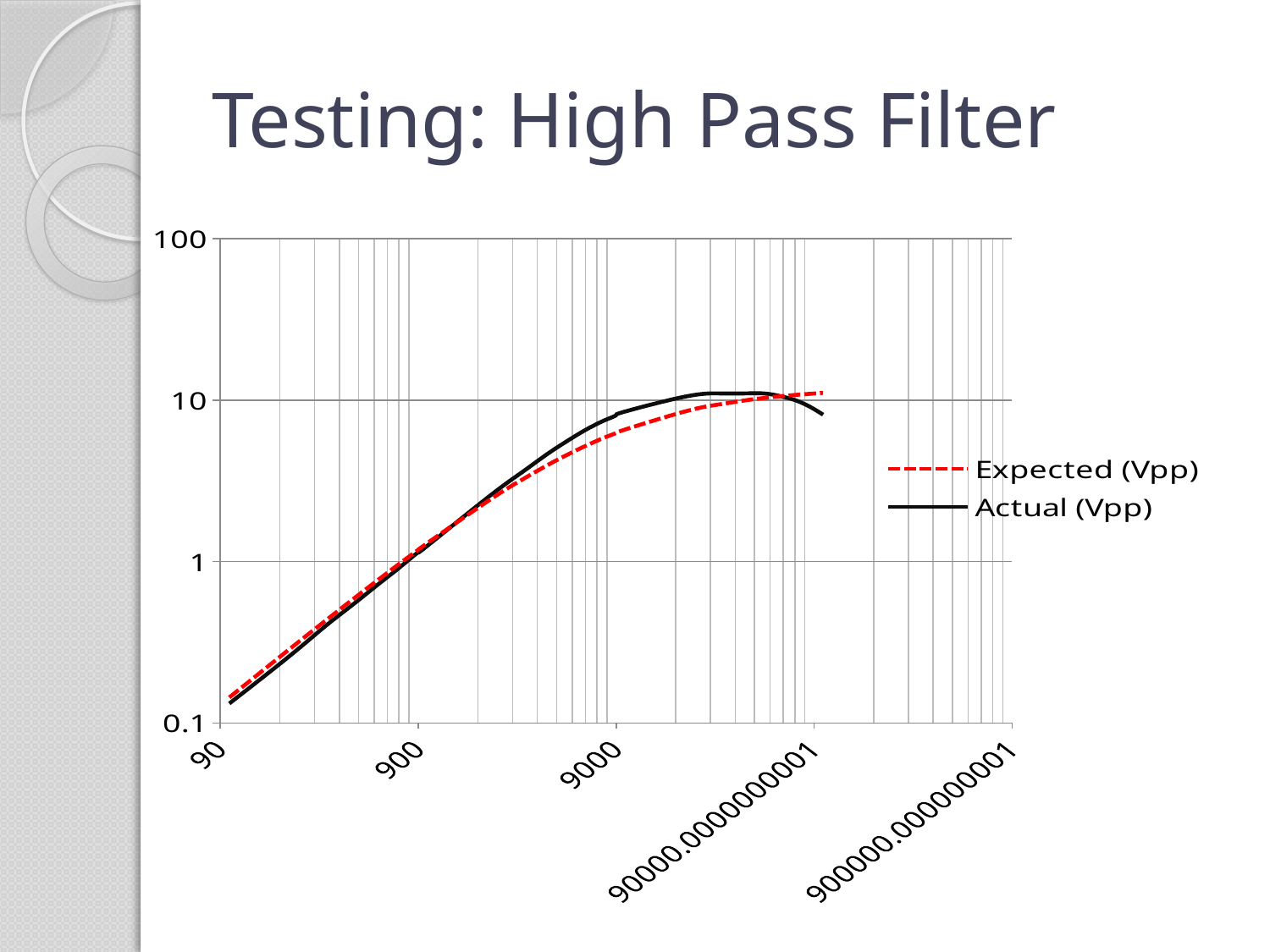
Is the Actual (Vpp) value at x = 9000 greater or less than 10? less Which series is drawn as a red dashed line? Expected (Vpp) Do the Expected (Vpp) values rise or fall as the x axis goes from 90 to 9000? Rise Does the Actual (Vpp) line rise or fall at its final point, after x = 90000.0000000001? Fall What is the highest value labelled on the y axis? 100 What kind of chart is shown on the slide? Line chart How many series does the legend list? 2 What are the two series named in the legend? Expected (Vpp) and Actual (Vpp) Is the Actual (Vpp) value at x = 9000 greater or less than 1? greater Is the Expected (Vpp) value at x = 90 greater or less than 1? less At x = 9000, which series has the larger value, Expected (Vpp) or Actual (Vpp)? Actual (Vpp)